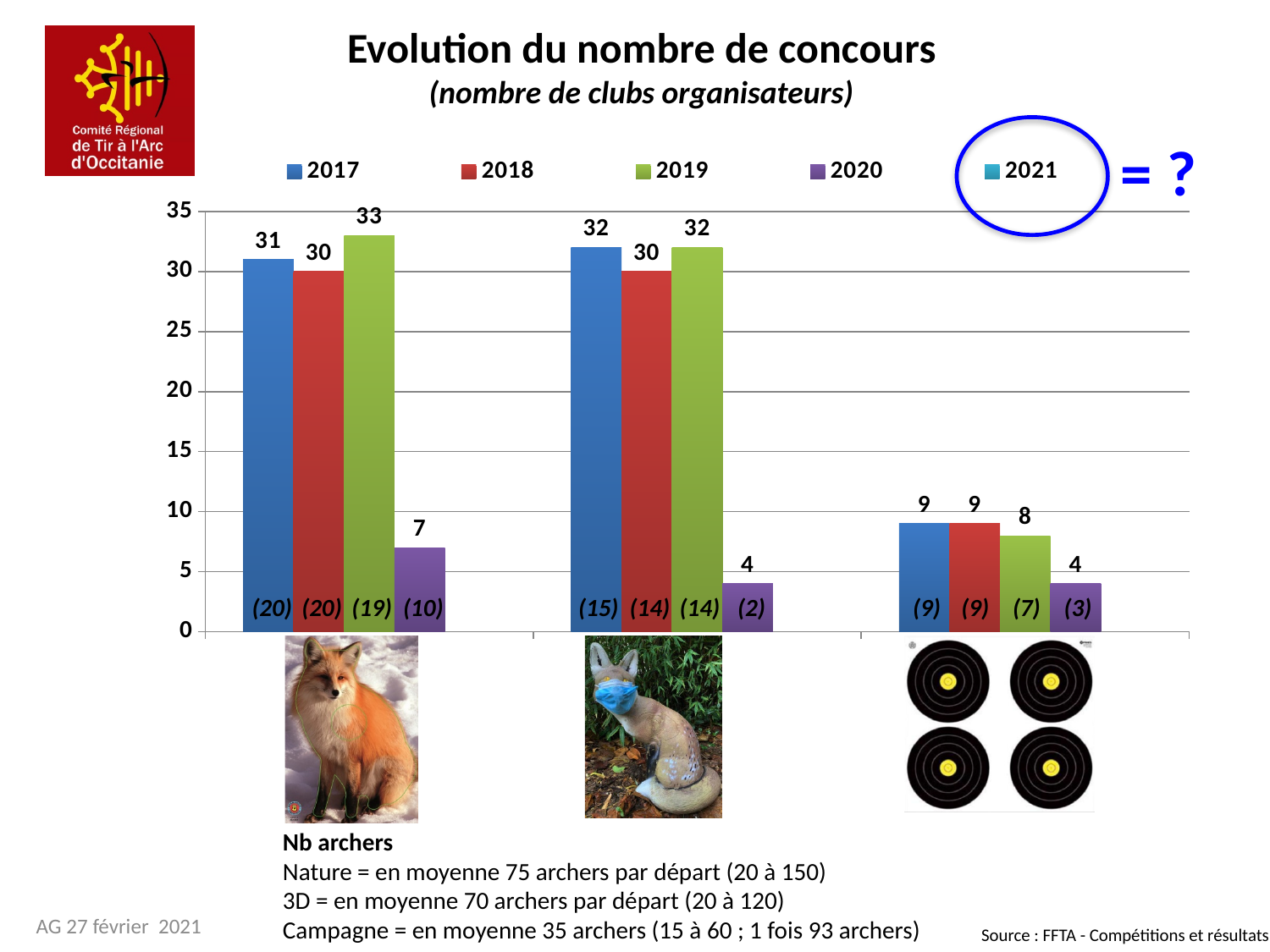
In the leftmost group of bars, which year has the highest value? 2019 What is the value for 2020 in the middle group of bars? 4 Is the 2018 value in the middle group greater or less than 25? greater What is the title of the chart? Evolution du nombre de concours What is the value for 2018 in the rightmost group of bars? 9 What type of chart is shown on the slide? bar chart How many series does the legend list? 5 How many groups of bars are plotted on the chart? 3 What is the value for 2019 in the leftmost group of bars? 33 In the leftmost group, what is the difference between the 2017 value and the 2020 value? 24 Which is larger: the 2017 value in the leftmost group or the 2017 value in the middle group? the middle group In the rightmost group of bars, which year has the lowest value? 2020